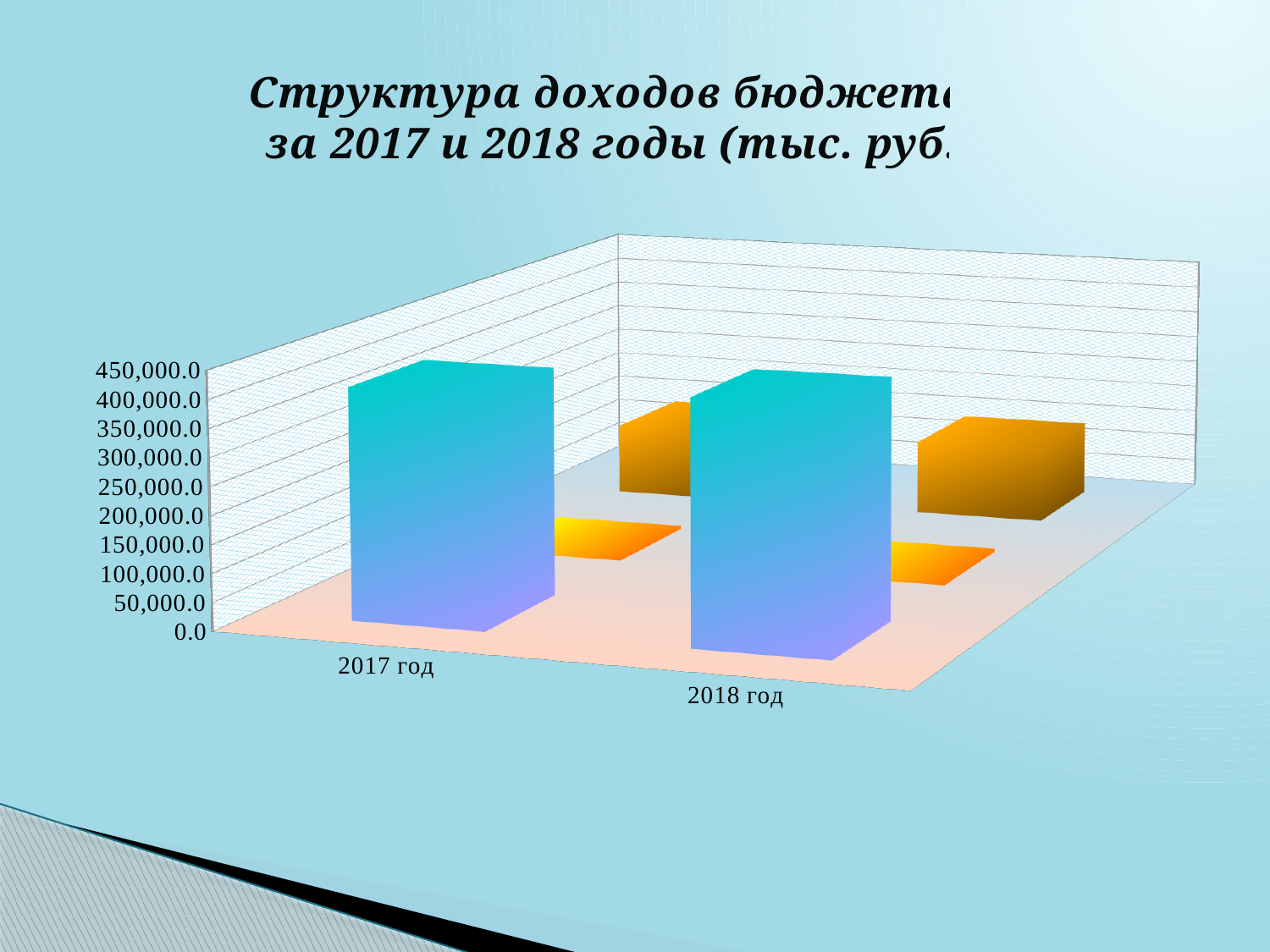
What is the highest value shown on the vertical axis? 450,000.0 What are the two category labels on the x axis? 2017 год, 2018 год Which series has the smallest bar in 2018 год: blue, yellow or orange? yellow Is the value of the tallest (blue) bar for 2018 год greater or less than 300,000.0? greater How many bars are plotted for the category 2017 год? 3 For 2017 год, which is larger: the blue bar or the orange bar? the blue bar How many categories are shown on the x axis of the chart? 2 For 2018 год, which is larger: the orange bar or the yellow bar? the orange bar Is the value of the yellow bar for 2017 год greater or less than 150,000.0? less Is the value of the yellow bar for 2018 год greater or less than 150,000.0? less What type of chart is shown on the slide? bar chart